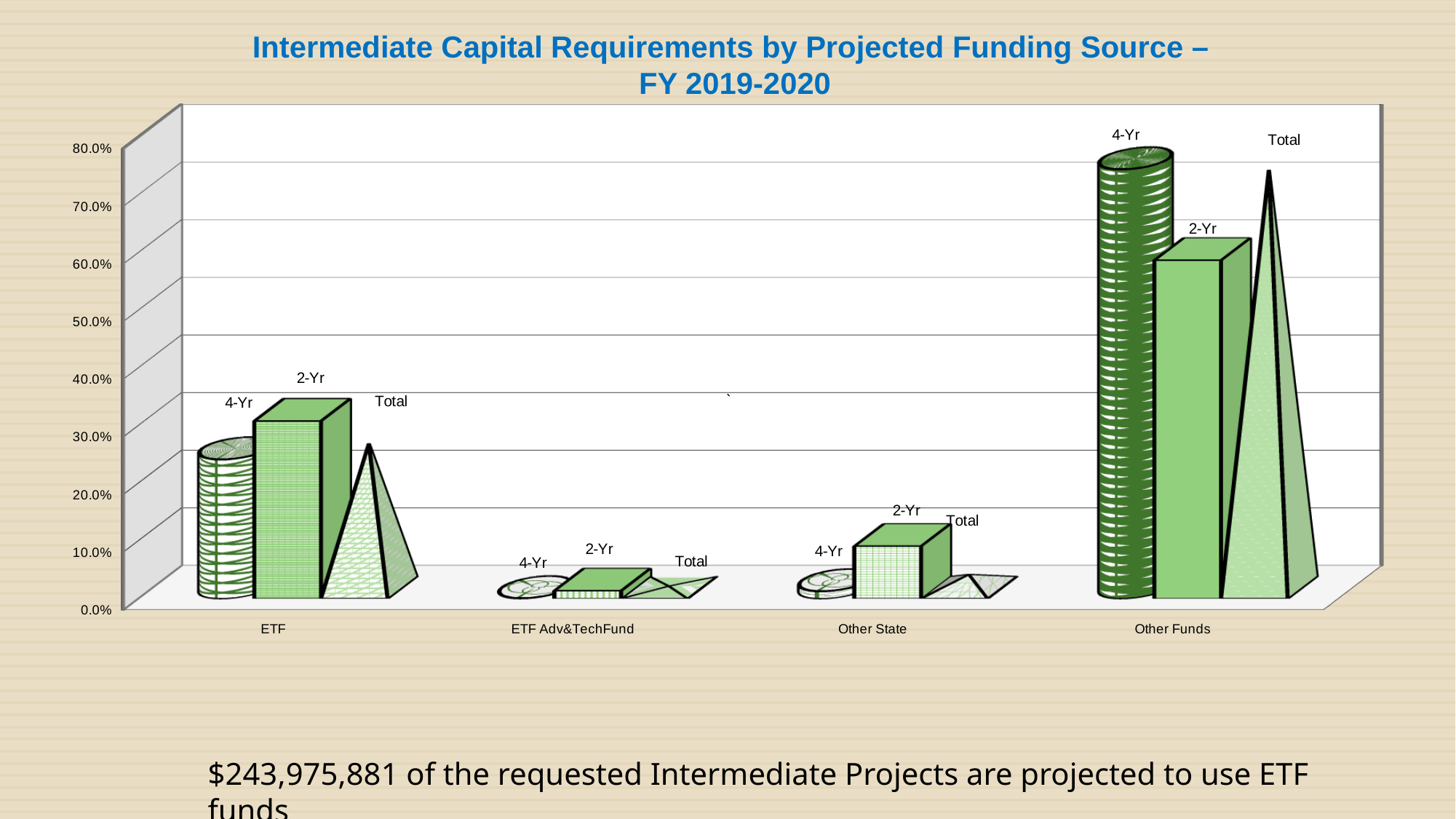
For Other Funds, which is larger, the 4-Yr value or the 2-Yr value? 4-Yr What is the title of the chart? Intermediate Capital Requirements by Projected Funding Source – FY 2019-2020 Is the 2-Yr value for ETF Adv&TechFund greater or less than 10%? less Which funding source has the lowest 2-Yr value? ETF Adv&TechFund For ETF, which is larger, the 2-Yr value or the 4-Yr value? 2-Yr What kind of chart is shown on the slide? bar chart Which funding source has the highest 4-Yr value? Other Funds Is the 4-Yr value for ETF greater or less than 30%? less Is the 2-Yr value for Other Funds greater or less than 50%? greater How many series are plotted for each funding source category? 3 How many funding source categories are shown on the x axis? 4